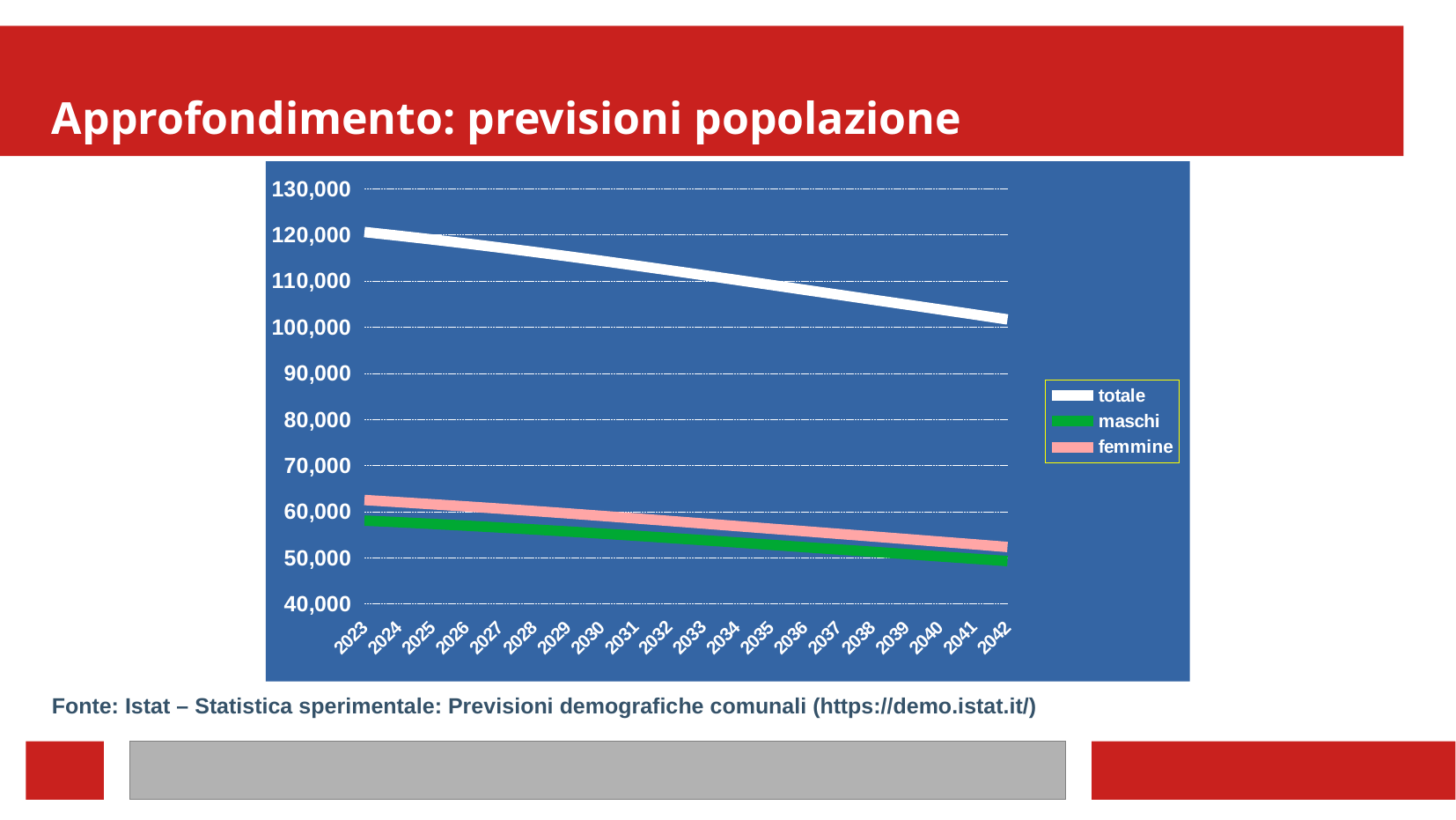
What is the last year shown on the x axis? 2042 Is the value for 'femmine' in 2023 greater or less than 60,000? greater Does the 'maschi' series rise or fall over the period shown? fall How many years are shown along the x axis? 20 Is the value for 'totale' in 2042 greater or less than 110,000? less How many series does the legend list? 3 Does the 'totale' series rise or fall from 2023 to 2042? fall Is the value for 'totale' in 2042 greater or less than 100,000? greater What is the first year shown on the x axis? 2023 What kind of chart is shown on the slide? line chart In 2023, which is larger: 'maschi' or 'femmine'? femmine